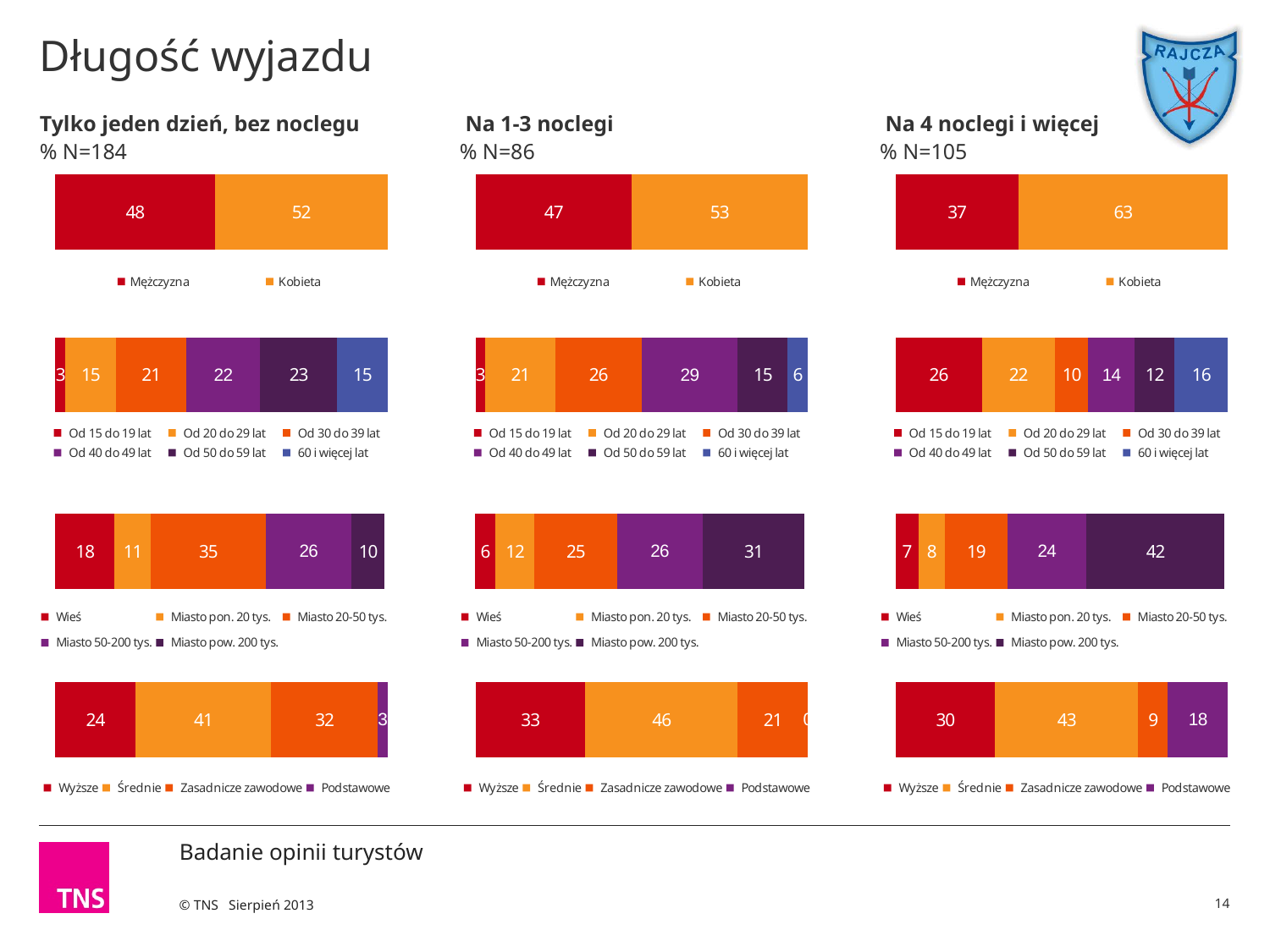
In the place-of-residence chart under "Tylko jeden dzień, bez noclegu", which category has the lowest value? Miasto pow. 200 tys. In the age chart under "Na 4 noclegi i więcej", what is the value for Od 15 do 19 lat? 26 In the education chart under "Na 1-3 noclegi", what is the difference between Średnie and Wyższe? 13 In the place-of-residence chart under "Na 4 noclegi i więcej", what is the value for Miasto pow. 200 tys.? 42 How many series does the legend of the age chart under "Tylko jeden dzień, bez noclegu" list? 6 What kind of chart is the gender chart under "Na 1-3 noclegi"? Stacked bar chart In the gender chart under "Tylko jeden dzień, bez noclegu", what is the value for Kobieta? 52 In the education chart under "Na 4 noclegi i więcej", which is larger: Zasadnicze zawodowe or Podstawowe? Podstawowe What is the sample size (N) shown for "Na 1-3 noclegi"? N=86 In the gender chart under "Na 4 noclegi i więcej", what is the value for Mężczyzna? 37 In the age chart under "Na 1-3 noclegi", which age group has the highest value? Od 40 do 49 lat What is the total of the gender bar under "Na 4 noclegi i więcej"? 100